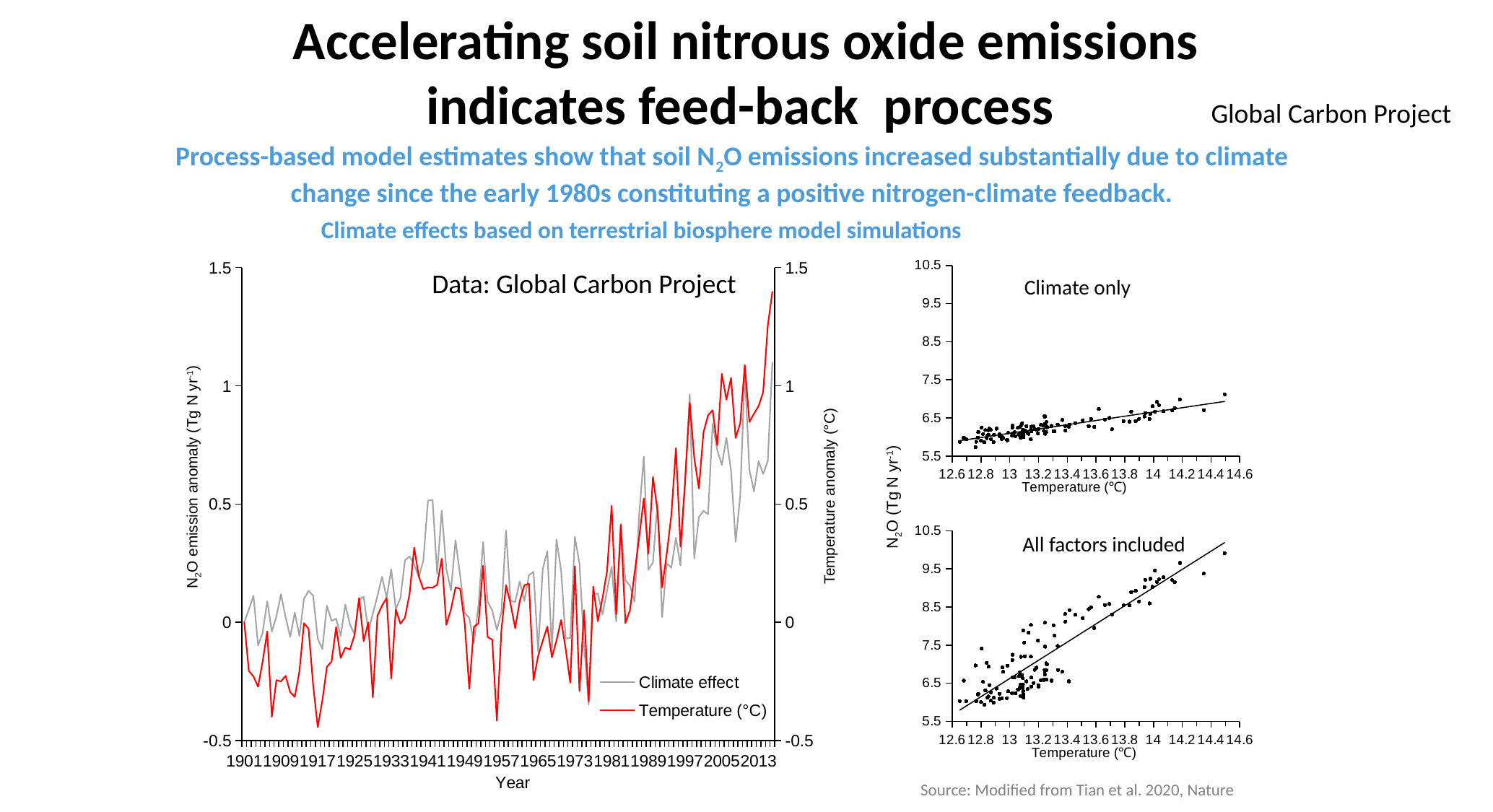
In the top-right 'Climate only' chart, is the highest N2O value greater or less than 7.5? less What kind of chart is the left chart titled 'Data: Global Carbon Project'? line chart In the left line chart, around 1917, which series has the lower value, Climate effect or Temperature (°C)? Temperature (°C) In the left line chart, does the Temperature (°C) series generally rise or fall from 1901 to 2013? rise What is the title of the bottom-right scatter chart? All factors included How many series does the legend of the left line chart list? 2 In the left line chart, is the final value of the Temperature (°C) series (around 2013) greater or less than 1? greater In the bottom-right 'All factors included' chart, do N2O values rise or fall as temperature increases? rise What are the two series named in the legend of the left line chart? Climate effect and Temperature (°C) In the bottom-right 'All factors included' chart, is the highest N2O value greater or less than 9.5? greater What kind of chart is the top-right chart titled 'Climate only'? scatter chart